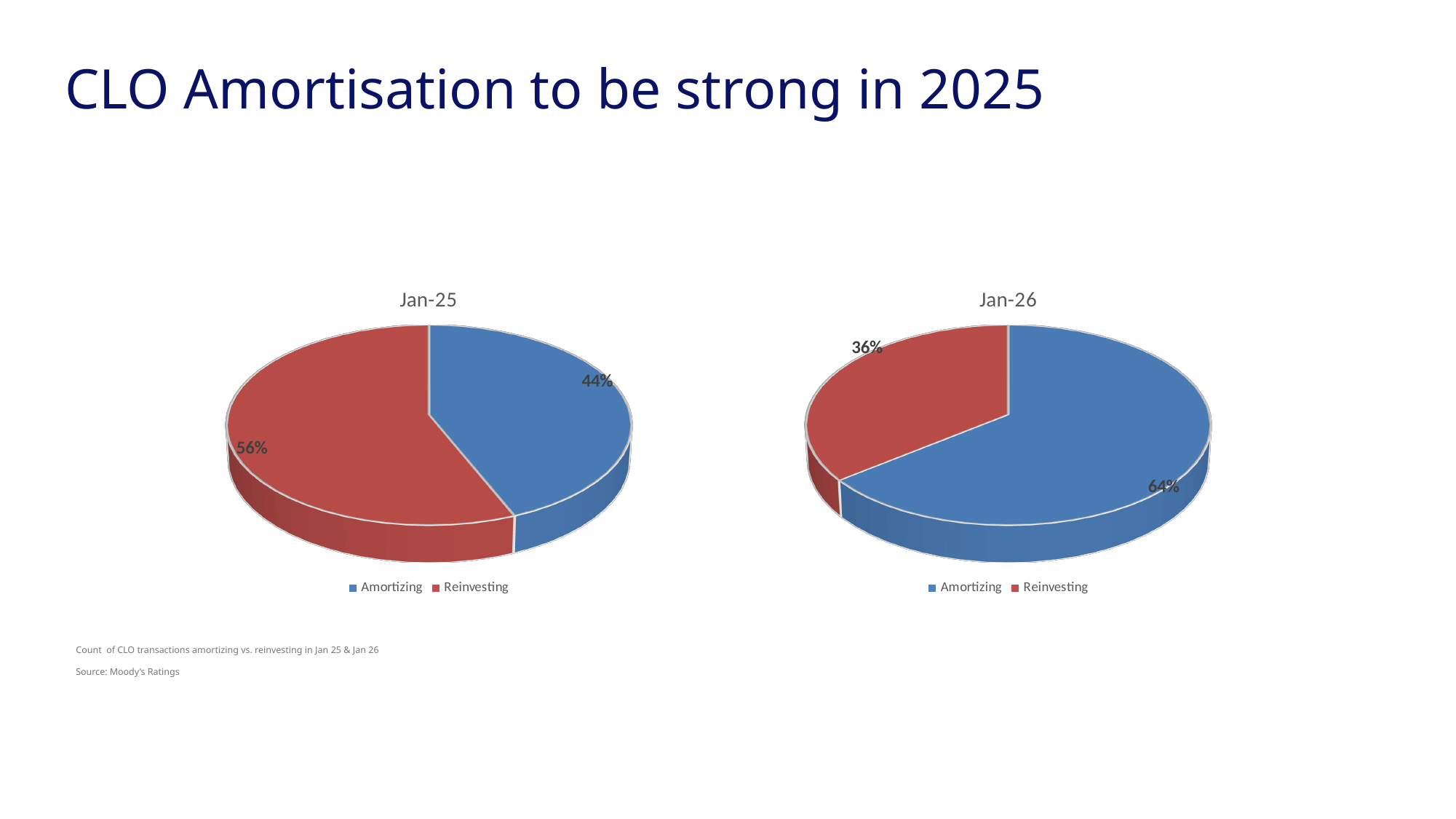
In the Jan-26 pie chart, which slice is the smallest? Reinvesting In the Jan-26 pie chart, which slice is the largest? Amortizing What colour is the Amortizing slice in the Jan-25 pie chart? Blue What kind of chart is the Jan-25 chart? Pie chart In the Jan-26 pie chart, what is the difference between the Amortizing and Reinvesting shares? 28% How many slices does the Jan-26 pie chart have? 2 In the Jan-25 pie chart, what share is Reinvesting? 56% In the Jan-26 pie chart, what share is Reinvesting? 36% In the Jan-25 pie chart, what is the difference between the Reinvesting and Amortizing shares? 12% In the Jan-26 pie chart, what share is Amortizing? 64% In the Jan-25 pie chart, which slice is larger, Amortizing or Reinvesting? Reinvesting In the Jan-25 pie chart, what share is Amortizing? 44%